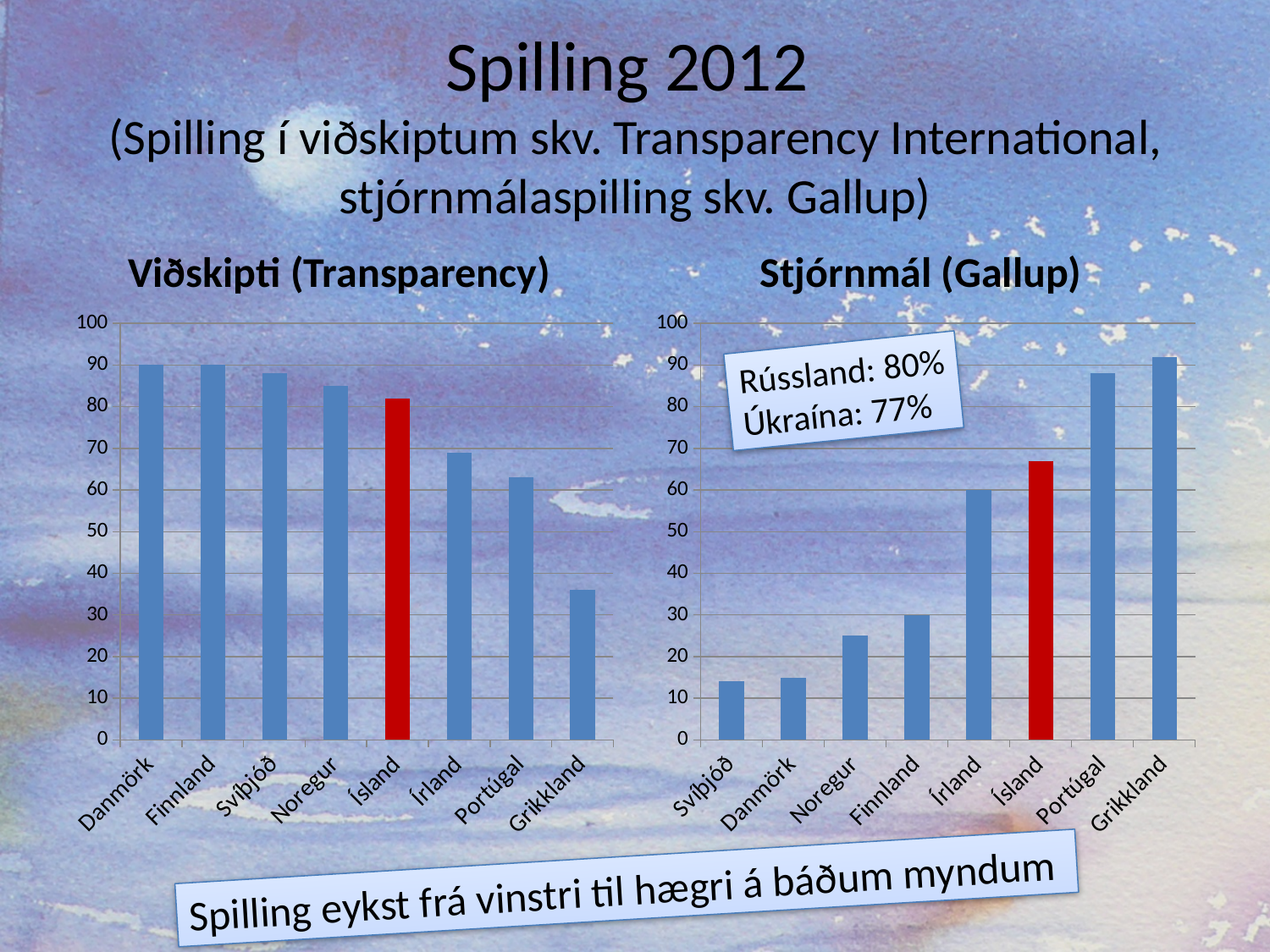
In the Stjórnmál (Gallup) chart, do the values rise or fall from left to right? rise In the Stjórnmál (Gallup) chart, is the value for Ísland greater or less than 60? greater In the Viðskipti (Transparency) chart, is the value for Ísland greater or less than 80? greater In the Viðskipti (Transparency) chart, which is larger, the value for Írland or the value for Portúgal? Írland In the Viðskipti (Transparency) chart, which country's bar is coloured red? Ísland How many countries are shown in the Stjórnmál (Gallup) chart? 8 What kind of chart is the Viðskipti (Transparency) chart? bar chart In the Viðskipti (Transparency) chart, is the value for Grikkland greater or less than 40? less In the Stjórnmál (Gallup) chart, which is larger, the value for Finnland or the value for Írland? Írland In the Stjórnmál (Gallup) chart, which country has the highest value? Grikkland In the Viðskipti (Transparency) chart, which country has the lowest value? Grikkland